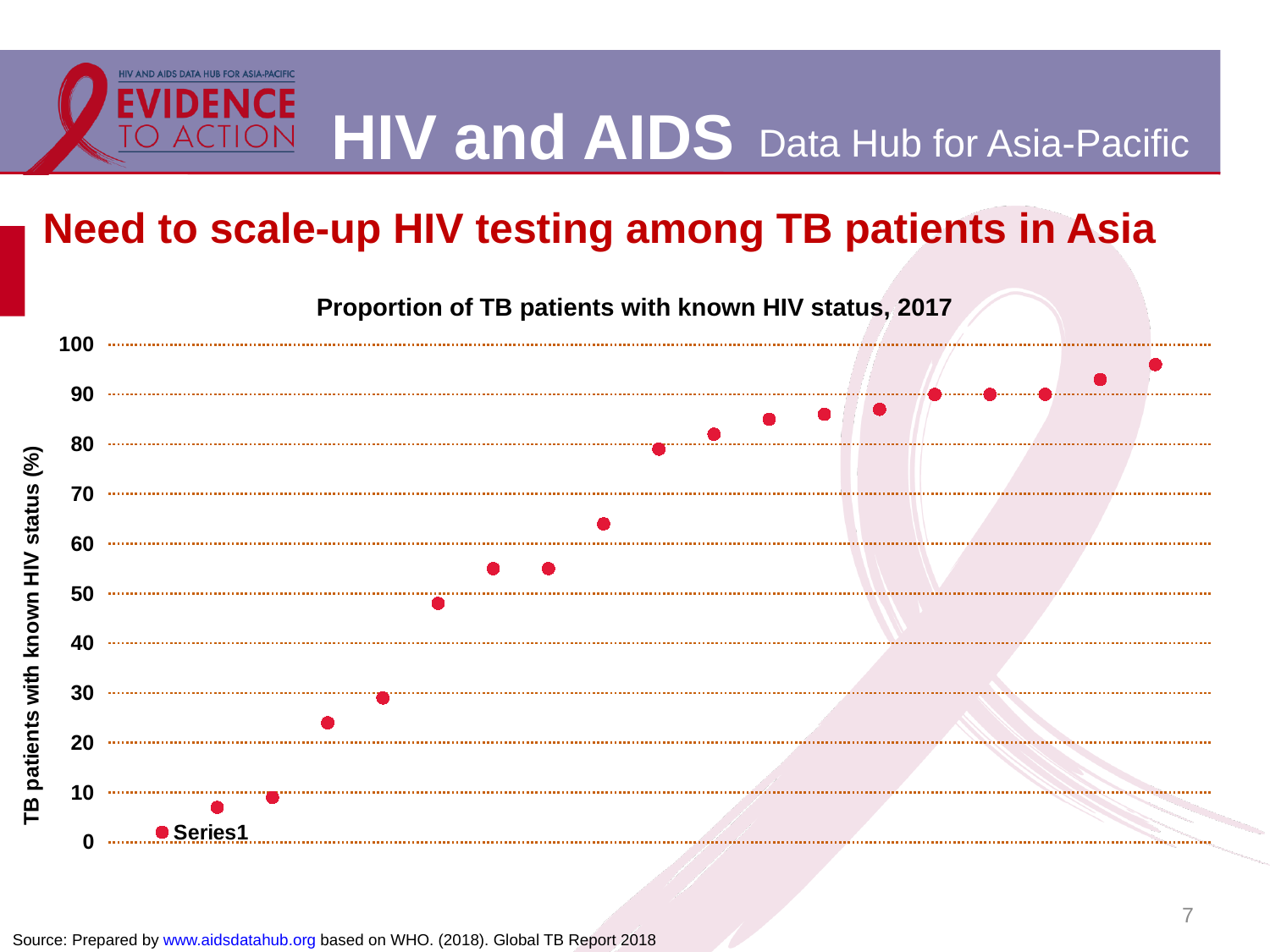
How many data points are plotted on the chart? 19 What is the title of the chart? Proportion of TB patients with known HIV status, 2017 Do the plotted values rise or fall from left to right along the x axis? Rise Is the value of the leftmost point greater or less than 10? less Which point has the higher value, the leftmost point or the rightmost point? The rightmost point Is the value of the highest point on the chart greater or less than 90? greater What is the maximum value shown on the y axis? 100 What kind of chart is shown on the slide? Scatter (dot) chart Is the value of the lowest point on the chart greater or less than 20? less